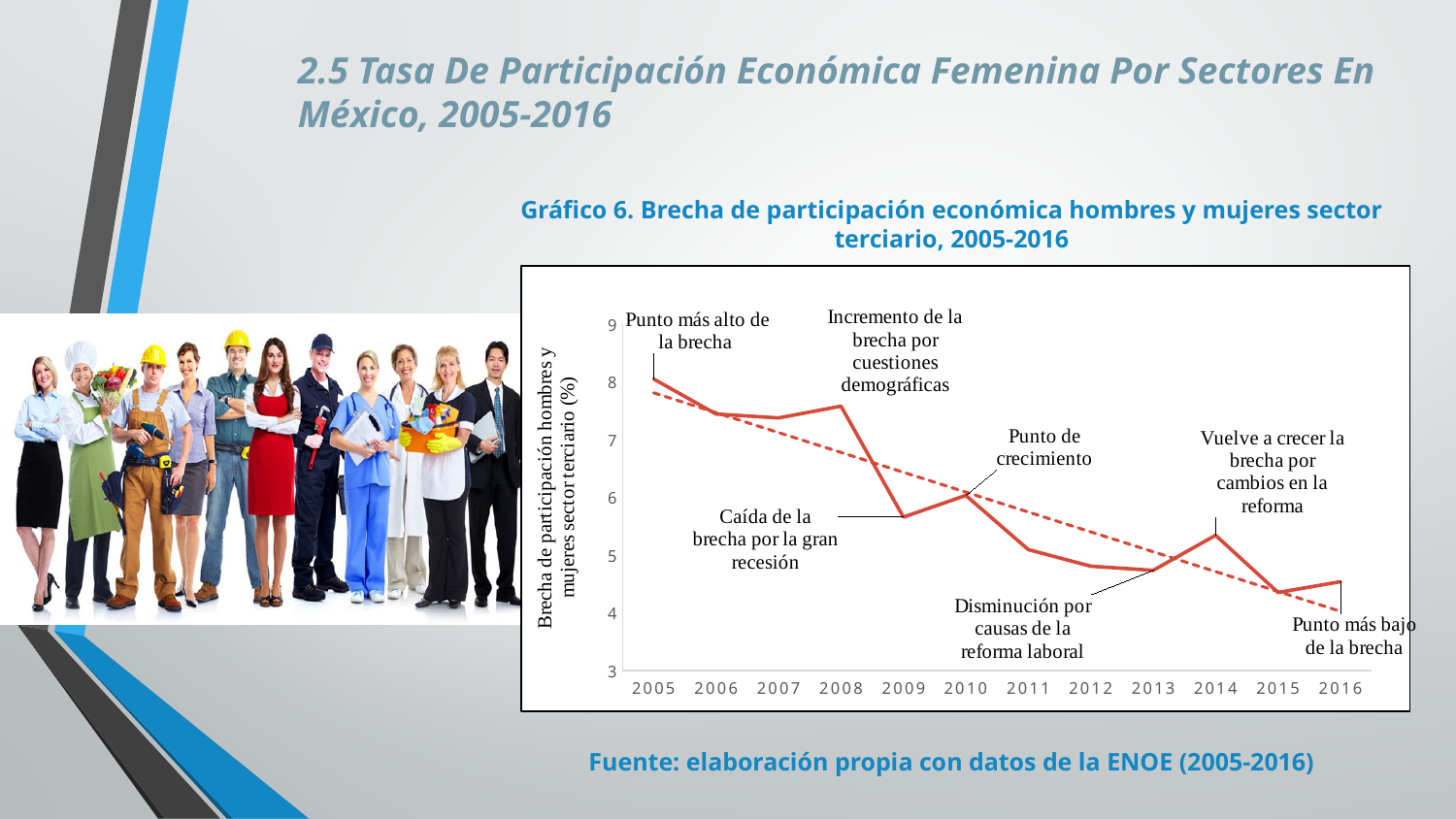
What kind of chart is shown on the slide? Line chart How many years are plotted along the x axis of the chart? 12 Which is larger, the value for 2013 or the value for 2014? 2014 Is the value for 2009 greater or less than 6? less Is the value for 2005 greater or less than 7? greater Is the value for 2016 greater or less than 5? less Overall, do the values rise or fall from 2005 to 2016? Fall Which is larger, the value for 2005 or the value for 2016? 2005 What is the title of the chart? Gráfico 6. Brecha de participación económica hombres y mujeres sector terciario, 2005-2016 Which year has the highest value for the gap (brecha) in the chart? 2005